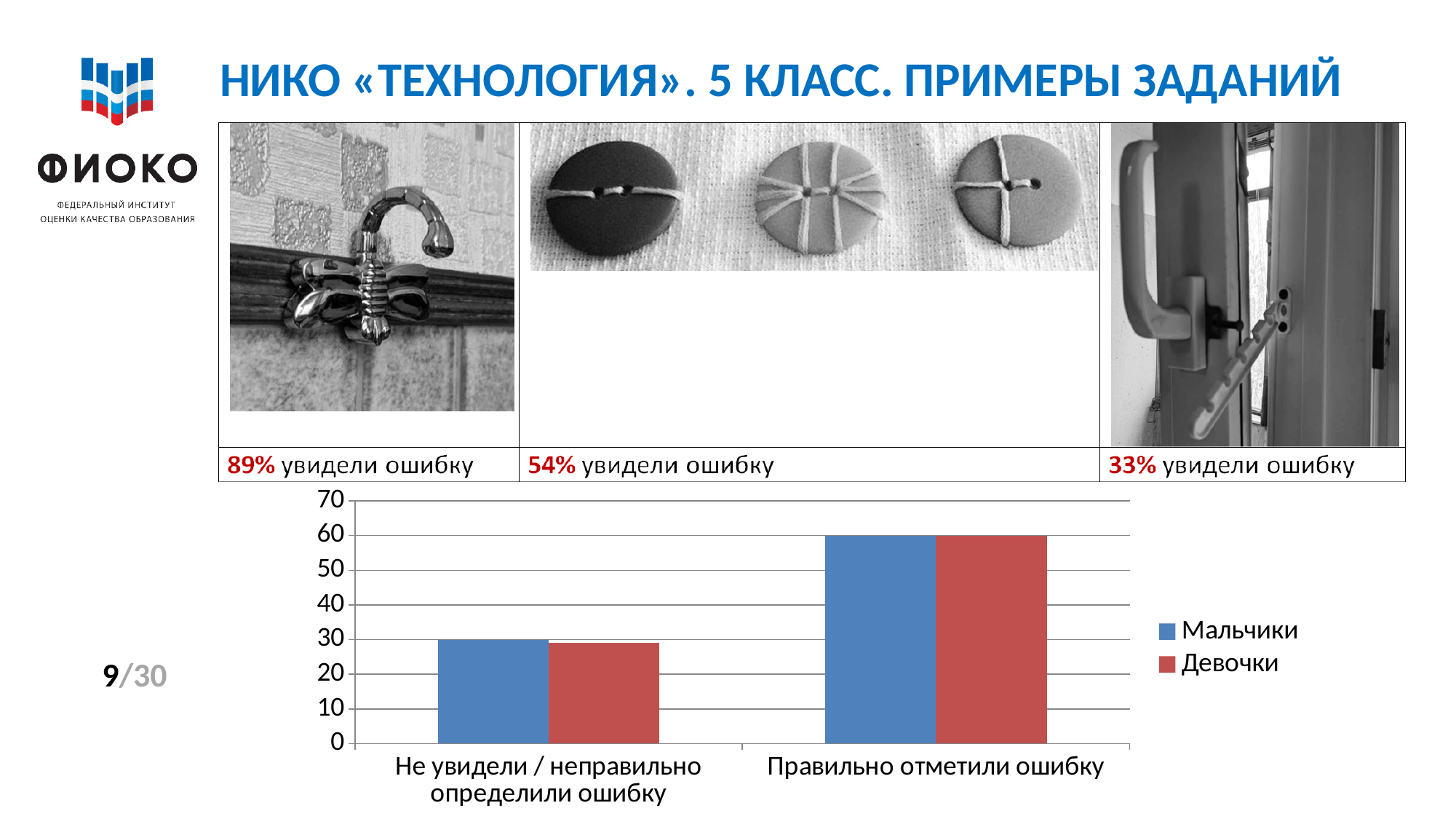
For Девочки, which category has the lower value? Не увидели / неправильно определили ошибку What is the value for Мальчики in the category 'Не увидели / неправильно определили ошибку'? 30 Do the values for Девочки rise or fall from the first category to the second along the x axis? rise For Мальчики, is the value for 'Правильно отметили ошибку' greater or less than 50? greater What is the value for Мальчики in the category 'Правильно отметили ошибку'? 60 How many series does the chart legend list? 2 What kind of chart is shown at the bottom of the slide? bar chart For Мальчики, which category has the higher value? Правильно отметили ошибку How many categories are shown on the x axis of the chart? 2 Which colour represents Девочки in the chart? red What are the two series named in the chart legend? Мальчики, Девочки For Девочки, is the value for 'Не увидели / неправильно определили ошибку' greater or less than 40? less